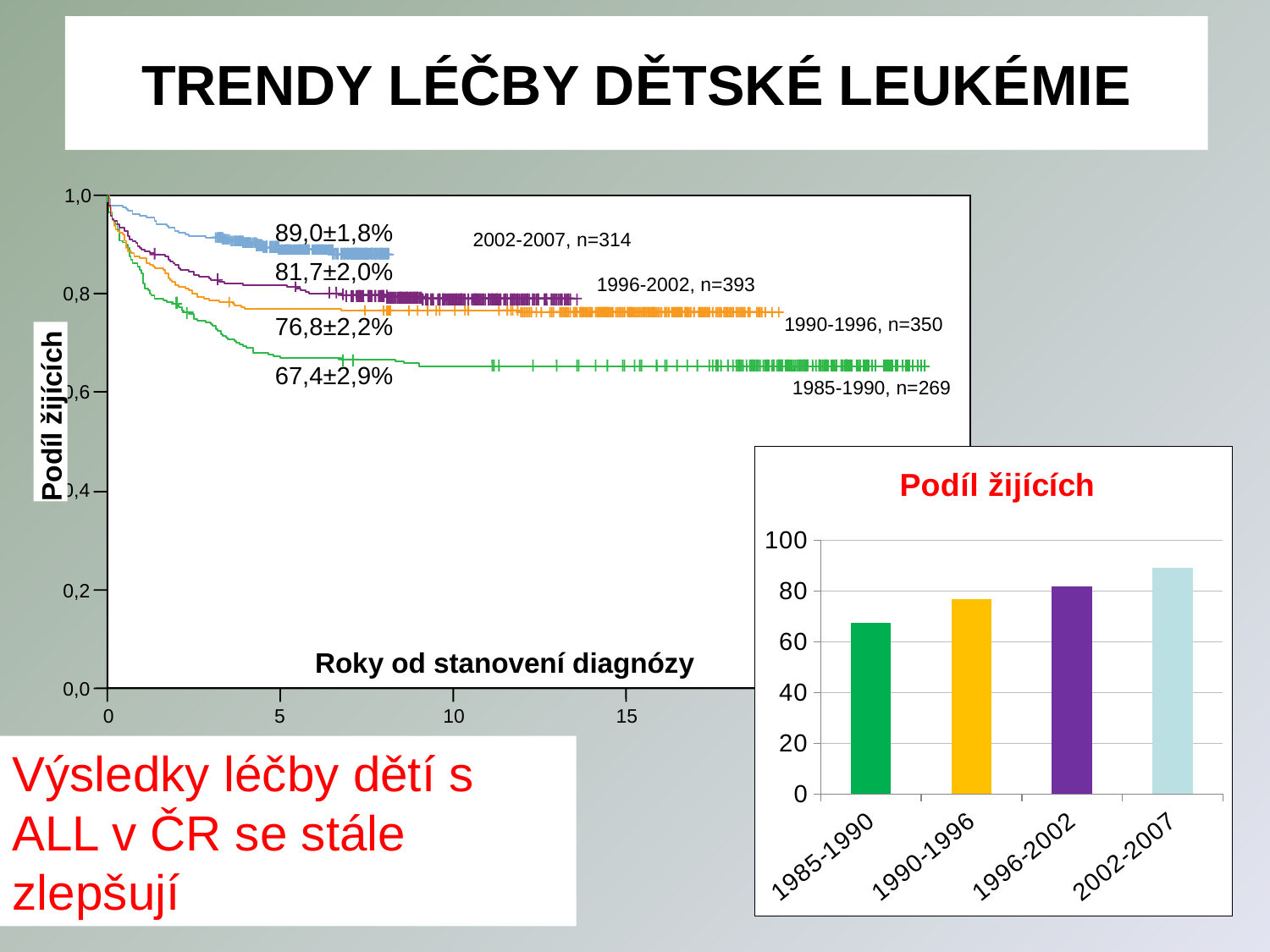
In the bar chart titled "Podíl žijících", which period has the tallest bar? 2002-2007 In the survival curve chart on the left, what is the n value given for the 1996-2002 group? 393 In the survival curve chart on the left, what survival value is printed for the 2002-2007 curve? 89,0±1,8% In the bar chart titled "Podíl žijících", which bar is taller: 1996-2002 or 1990-1996? 1996-2002 In the bar chart titled "Podíl žijících", is the value for 2002-2007 greater or less than 80? greater What kind of chart is the chart titled "Podíl žijících" on the right of the slide? bar chart In the survival curve chart on the left, what survival value is printed for the 1985-1990 curve? 67,4±2,9% In the bar chart titled "Podíl žijících", is the value for 1985-1990 greater or less than 80? less In the bar chart titled "Podíl žijících", do the bar values rise or fall from 1985-1990 to 2002-2007? rise In the survival curve chart on the left, what is the label of the x axis? Roky od stanovení diagnózy In the bar chart titled "Podíl žijících", how many period categories are shown on the x axis? 4 In the bar chart titled "Podíl žijících", which period has the shortest bar? 1985-1990